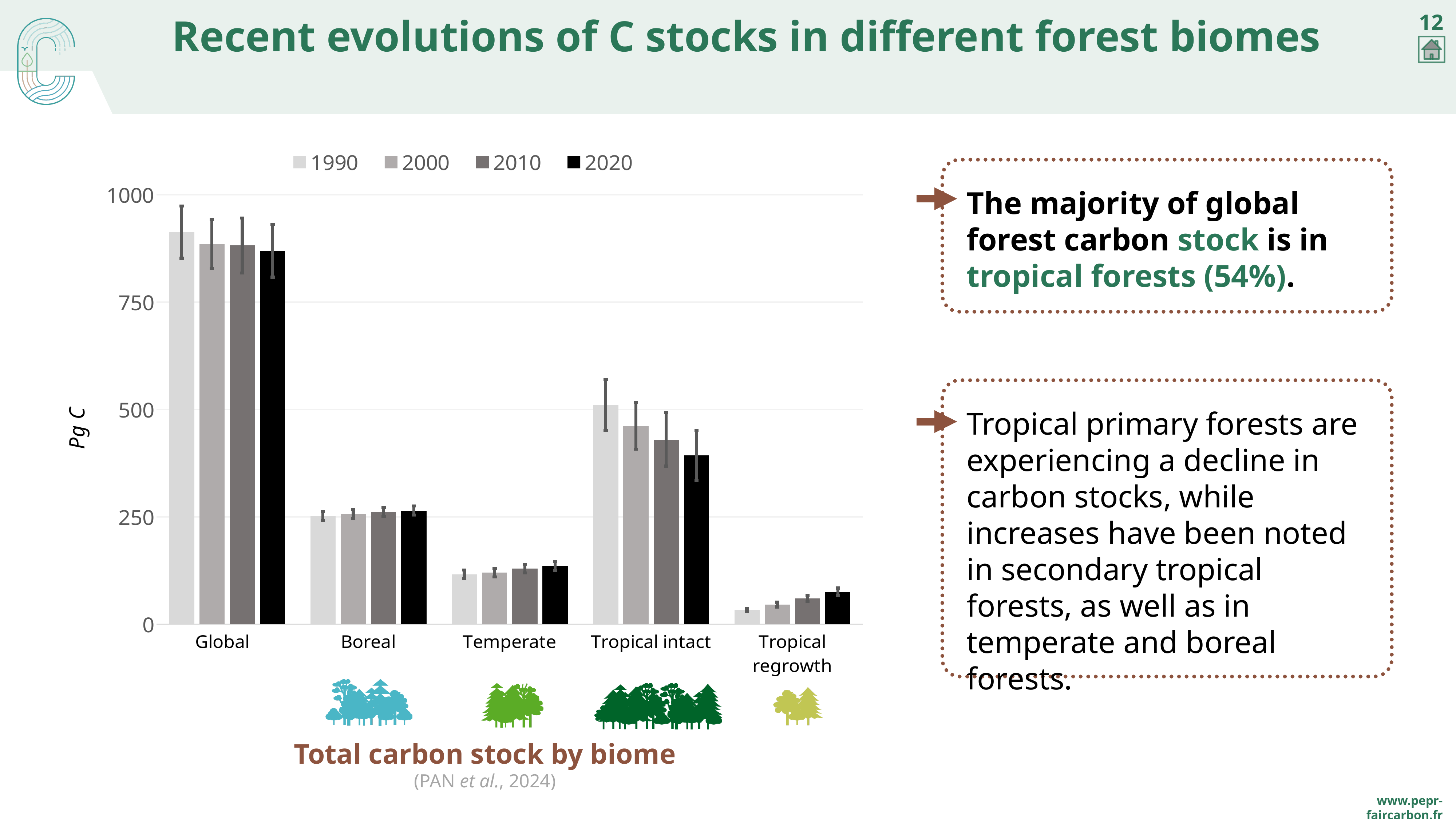
Is the value for Tropical intact in 2020 greater or less than 500? less What is the label on the y axis of the chart? Pg C Which category has the lowest value for 1990? Tropical regrowth Which is larger in 1990, the value for Tropical intact or the value for Boreal? Tropical intact Is the value for Temperate in 2020 greater or less than 250? less Is the value for Global in 1990 greater or less than 750? greater Do the values for Tropical regrowth rise or fall from 1990 to 2020? rise How many biome categories are shown on the x axis? 5 How many series does the legend list? 4 Do the values for Tropical intact rise or fall from 1990 to 2020? fall Which category has the highest value for 2020? Global What kind of chart is shown on the slide? bar chart